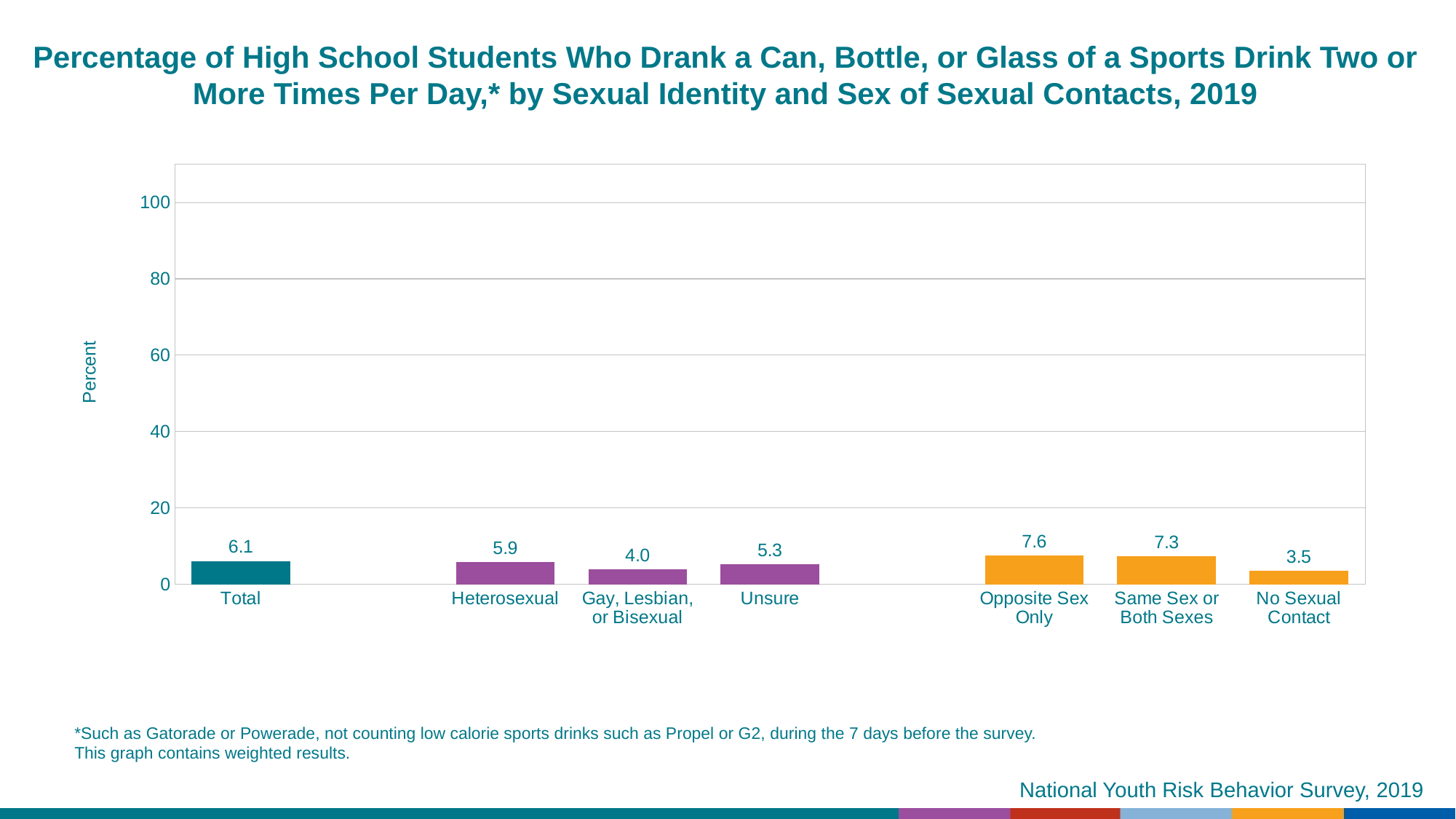
Which category has the lowest value? No Sexual Contact Which category has the highest value? Opposite Sex Only How many categories are shown on the x axis? 7 What is the difference between the values for Opposite Sex Only and No Sexual Contact? 4.1 What is the difference between the values for Heterosexual and Gay, Lesbian, or Bisexual? 1.9 Is the value for Same Sex or Both Sexes greater or less than 20? less What is the value for Gay, Lesbian, or Bisexual students? 4.0 What is the value for Total? 6.1 What kind of chart is shown on the slide? bar chart What percentage of Heterosexual students drank a sports drink two or more times per day? 5.9 What is the value for students with No Sexual Contact? 3.5 Which is larger, the value for Unsure or the value for Gay, Lesbian, or Bisexual? Unsure